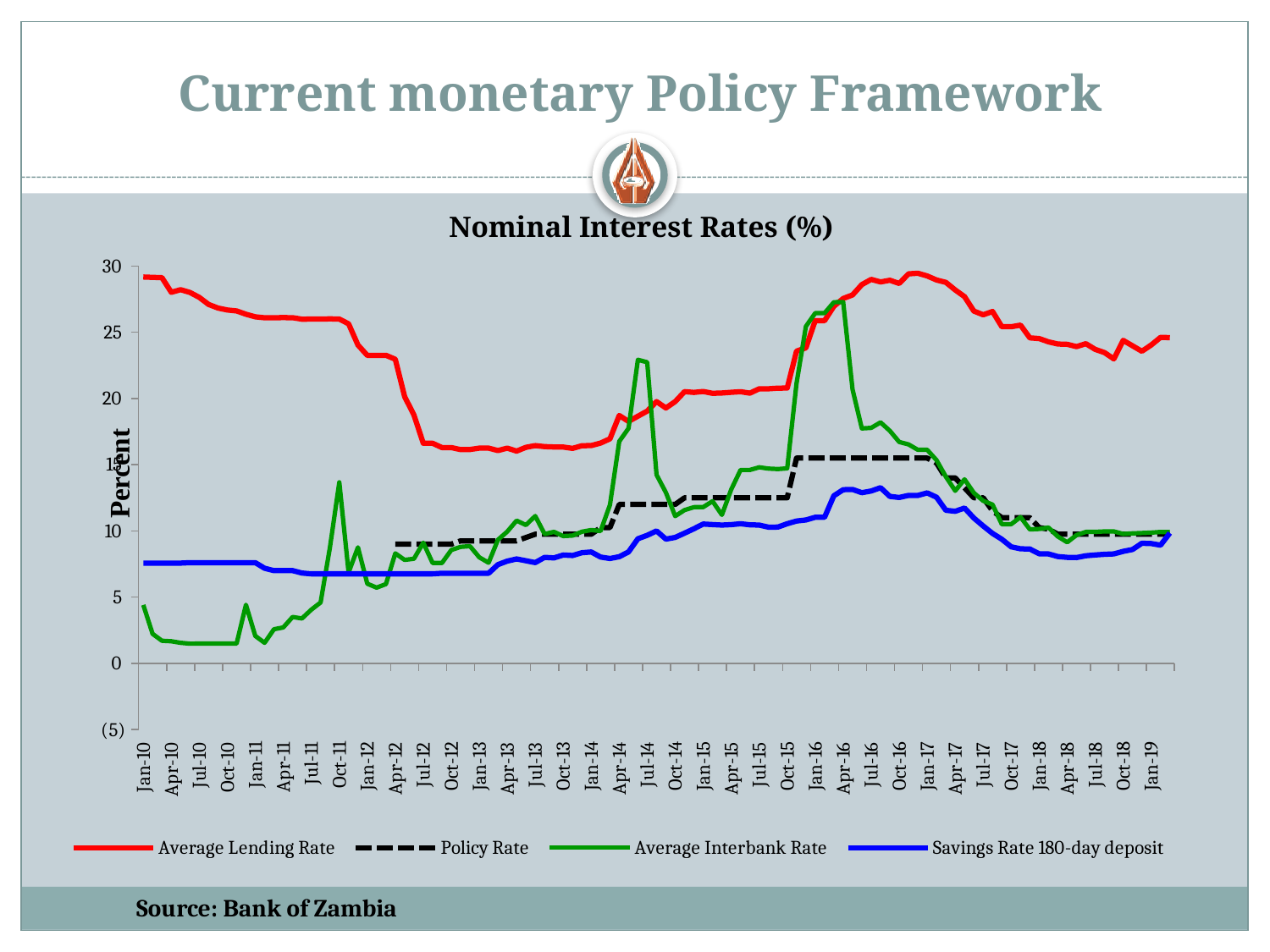
What kind of chart is shown on the slide? line chart Which series is drawn as a dashed line? Policy Rate At Jan-19, which is higher: the Average Lending Rate or the Average Interbank Rate? Average Lending Rate Is the Savings Rate 180-day deposit at Jan-10 greater or less than 10? less What is the title of the chart? Nominal Interest Rates (%) Is the Average Interbank Rate at Jan-10 greater or less than 5? less Does the Average Lending Rate rise or fall between Jan-10 and Jul-12? fall At Jan-16, which is higher: the Average Interbank Rate or the Policy Rate? Average Interbank Rate Is the Average Interbank Rate at Jul-14 greater or less than 20? greater How many series does the legend list? 4